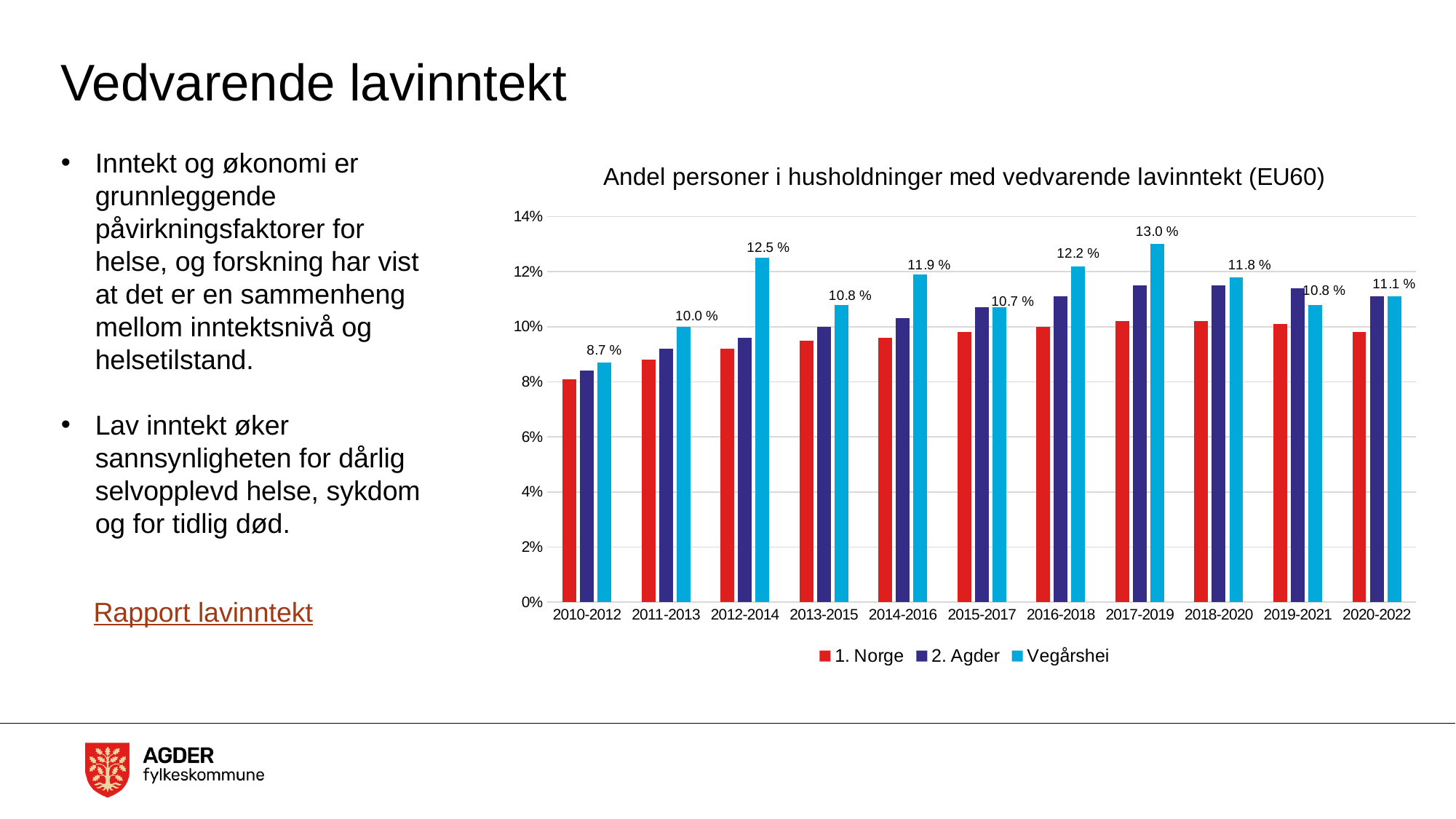
What is the value for Vegårshei in 2010-2012? 8.7 % How many series does the legend list? 3 What is the difference between the Vegårshei values for 2017-2019 and 2010-2012? 4.3 % What is the value for Vegårshei in 2014-2016? 11.9 % Is the value for 1. Norge in 2013-2015 greater or less than 10%? less In which period is the Vegårshei value highest? 2017-2019 What kind of chart is shown on the slide? Bar chart How many periods are shown on the x axis? 11 In which period is the Vegårshei value lowest? 2010-2012 What is the value for Vegårshei in 2017-2019? 13.0 % Which is larger, the Vegårshei value for 2012-2014 or for 2016-2018? 2012-2014 Is the value for 2. Agder in 2018-2020 greater or less than 10%? greater